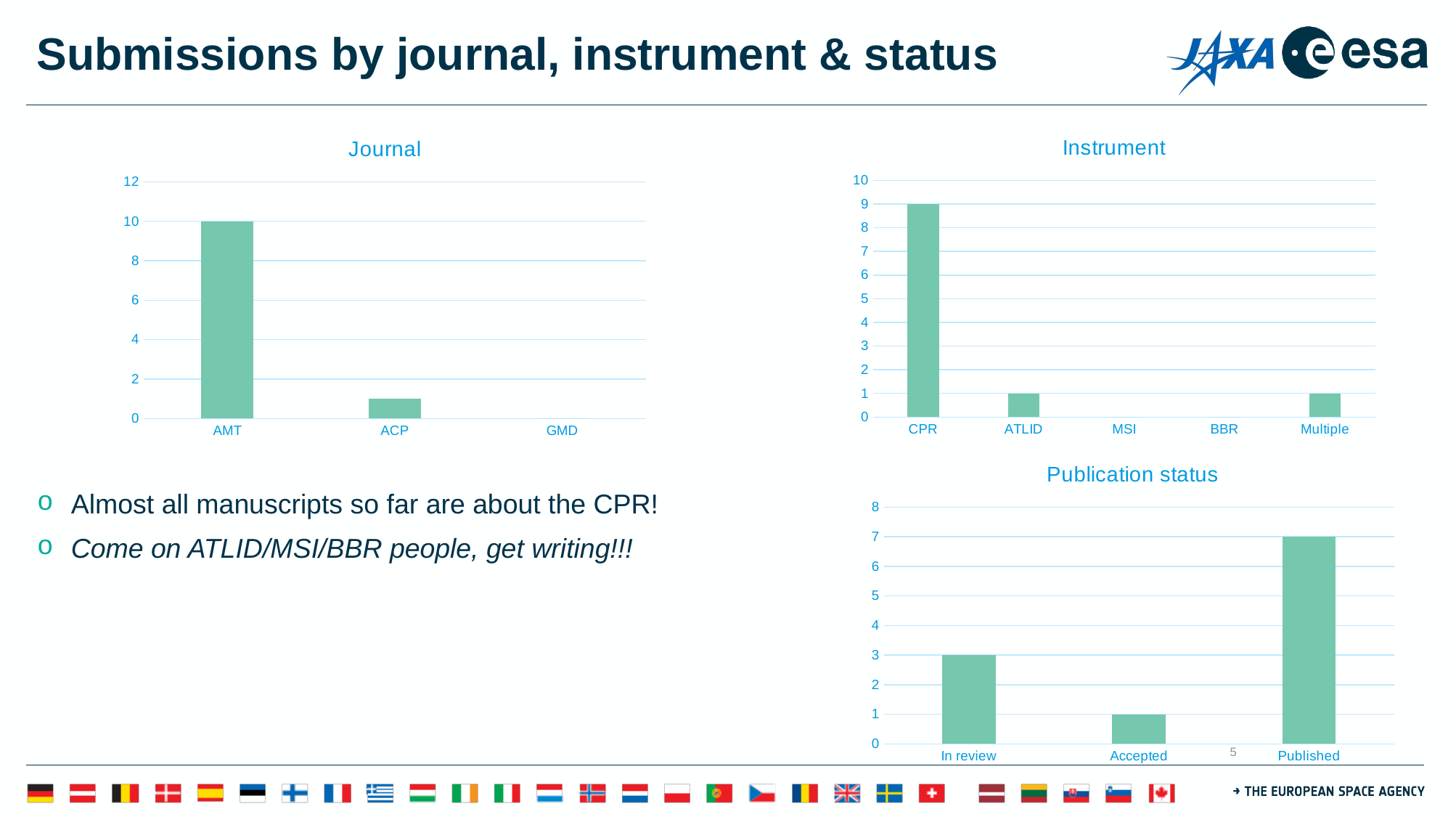
In the Instrument chart, is the value for CPR greater or less than 5? greater What kind of chart is the Publication status chart? Bar chart In the Publication status chart, which status has the lowest value? Accepted In the Instrument chart, which is larger, the value for CPR or the value for ATLID? CPR In the Journal chart, what is the value for AMT? 10 In the Publication status chart, what is the difference between the values for Published and In review? 4 In the Journal chart, how many categories are shown on the x axis? 3 In the Instrument chart, how many categories are shown on the x axis? 5 In the Journal chart, which journal has the highest number of submissions? AMT In the Instrument chart, what is the value for CPR? 9 In the Publication status chart, what is the value for Published? 7